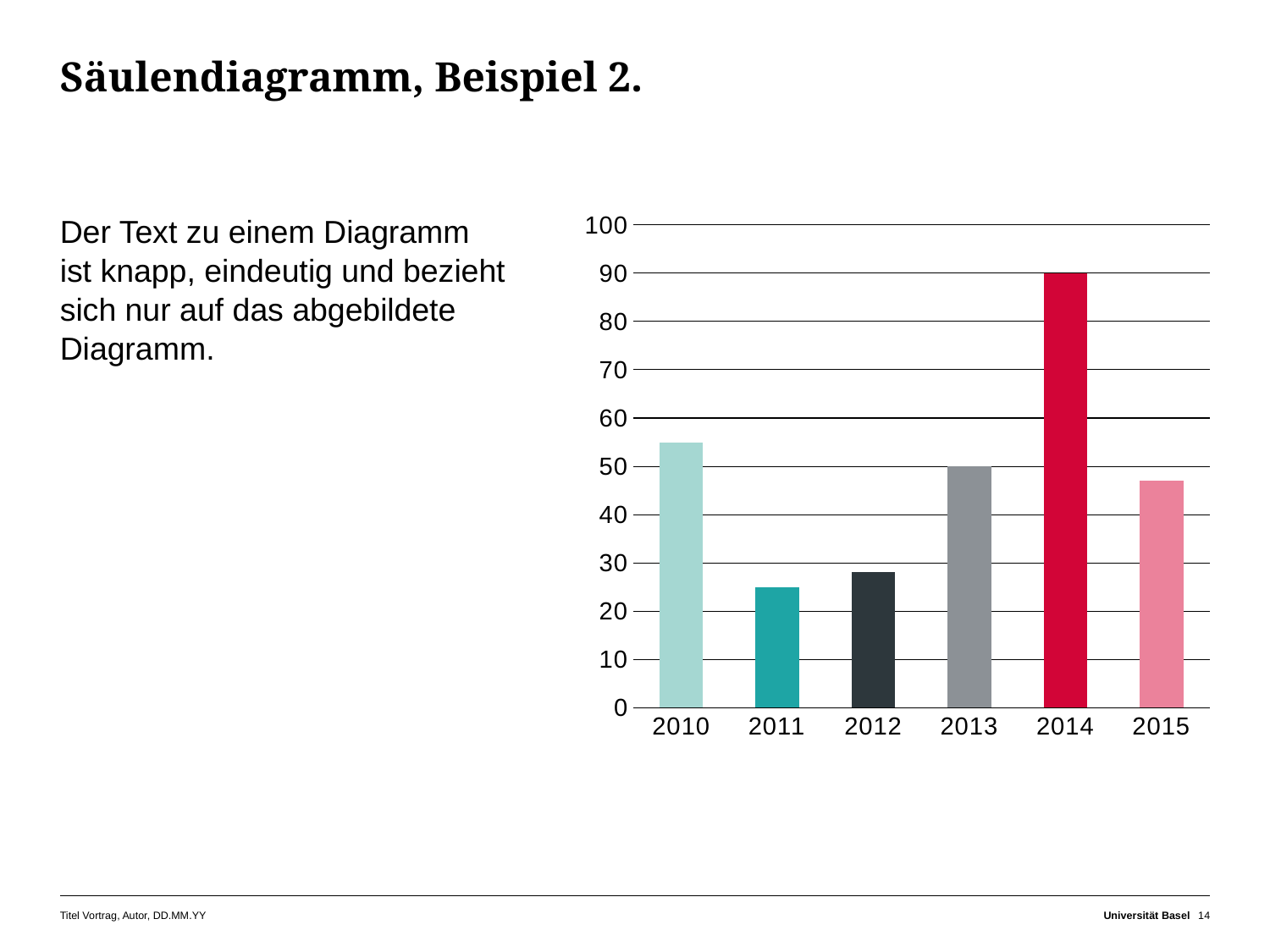
Which is larger, the value for 2010 or the value for 2015? 2010 What is the title of the slide containing the chart? Säulendiagramm, Beispiel 2. What kind of chart is shown on the slide? bar chart How many years are shown on the x axis of the chart? 6 What is the value for 2014 in the chart? 90 Is the value for 2011 greater or less than 30? less Which year has the lowest bar in the chart? 2011 What is the value for 2013 in the chart? 50 Is the value for 2010 greater or less than 50? greater Is the value for 2015 greater or less than 50? less Which year has the highest bar in the chart? 2014